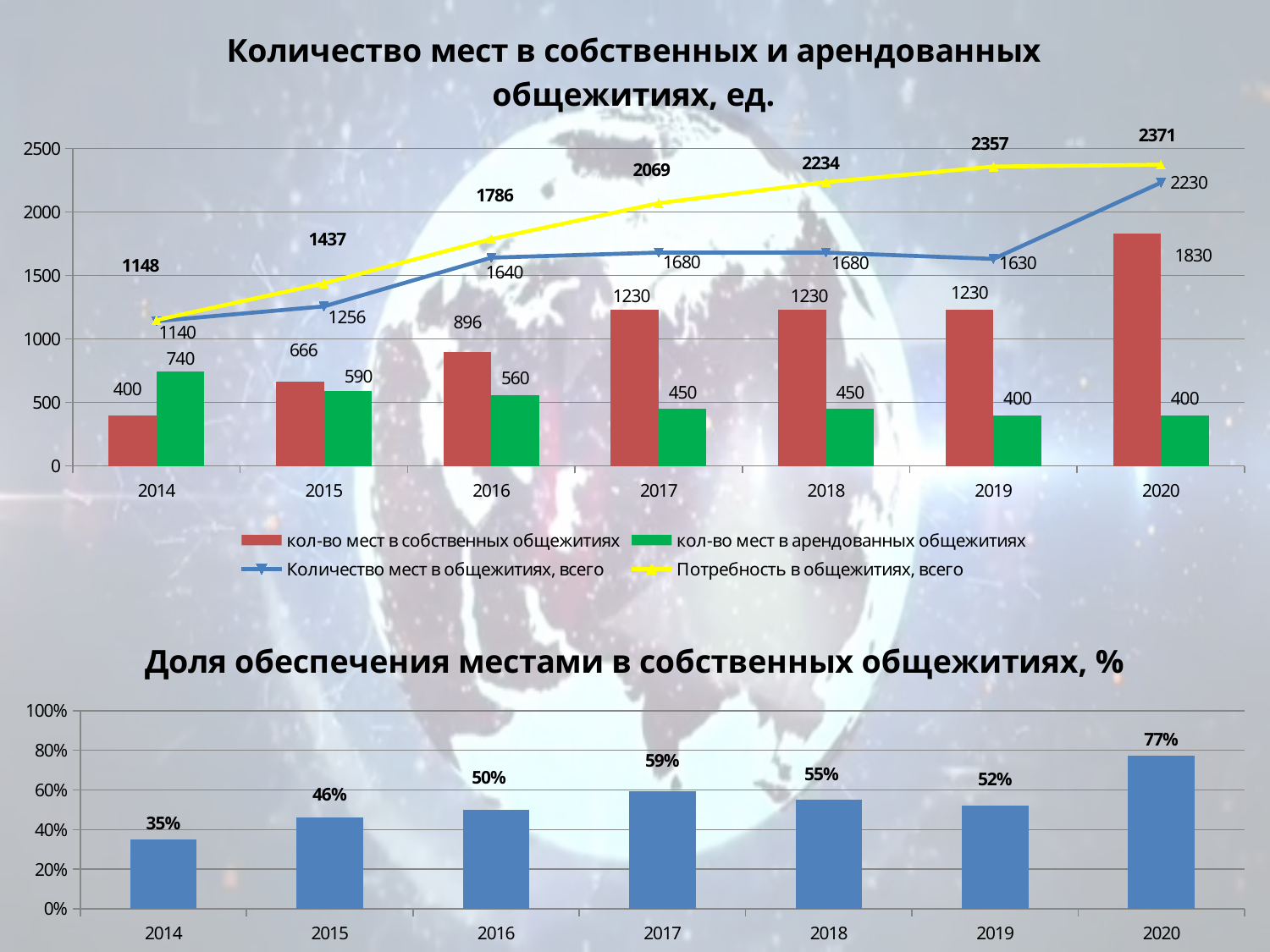
In the top chart, what is the value for 'кол-во мест в арендованных общежитиях' in 2014? 740 In the bottom chart 'Доля обеспечения местами в собственных общежитиях, %', what is the value for 2017? 59% In the bottom chart, what is the difference between the values for 2020 and 2019? 25% In the top chart 'Количество мест в собственных и арендованных общежитиях, ед.', what is the value for 'кол-во мест в собственных общежитиях' in 2016? 896 What type of chart is the bottom chart? bar chart In the top chart, which is larger in 2015: 'кол-во мест в собственных общежитиях' or 'кол-во мест в арендованных общежитиях'? кол-во мест в собственных общежитиях In the bottom chart, which year has the lowest value? 2014 In the top chart, what is the value of 'Потребность в общежитиях, всего' in 2019? 2357 In the top chart, in which year is 'кол-во мест в собственных общежитиях' highest? 2020 In the top chart, does 'кол-во мест в арендованных общежитиях' generally rise or fall from 2014 to 2020? fall In the top chart, what is the difference between 'Потребность в общежитиях, всего' and 'Количество мест в общежитиях, всего' in 2019? 727 How many series does the legend of the top chart list? 4